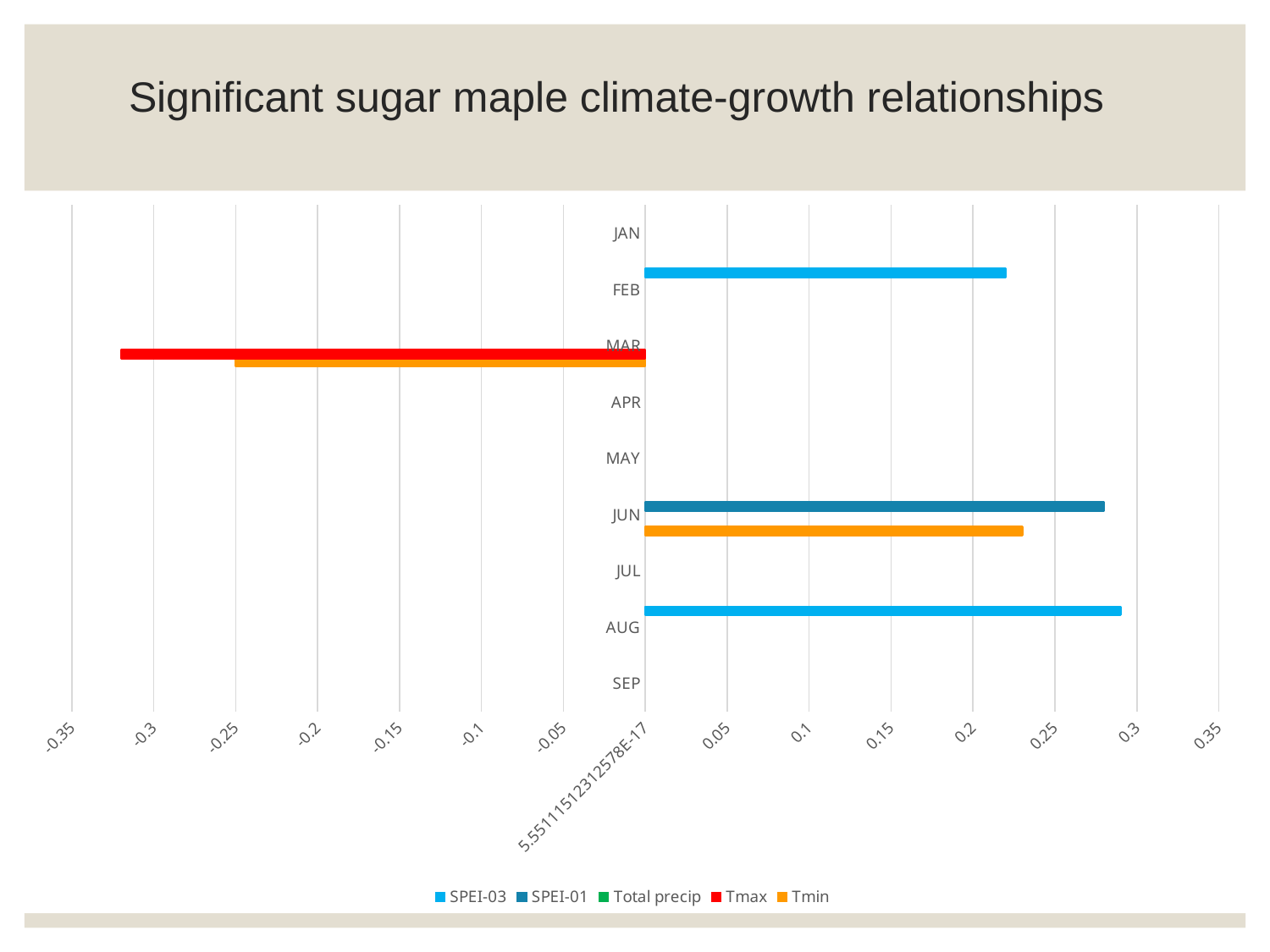
Is the SPEI-03 value for AUG greater or less than 0.3? less How many series does the legend list? 5 Which is larger, the SPEI-03 value for AUG or the SPEI-03 value for FEB? AUG Is the Tmin value for JUN greater or less than 0.2? greater What is the title of the slide? Significant sugar maple climate-growth relationships Which series has the most negative value on the chart? Tmax Is the SPEI-03 value for FEB greater or less than 0.2? greater What kind of chart is shown on the slide? bar chart In JUN, which is larger, the SPEI-01 value or the Tmin value? SPEI-01 How many months are listed on the vertical axis? 9